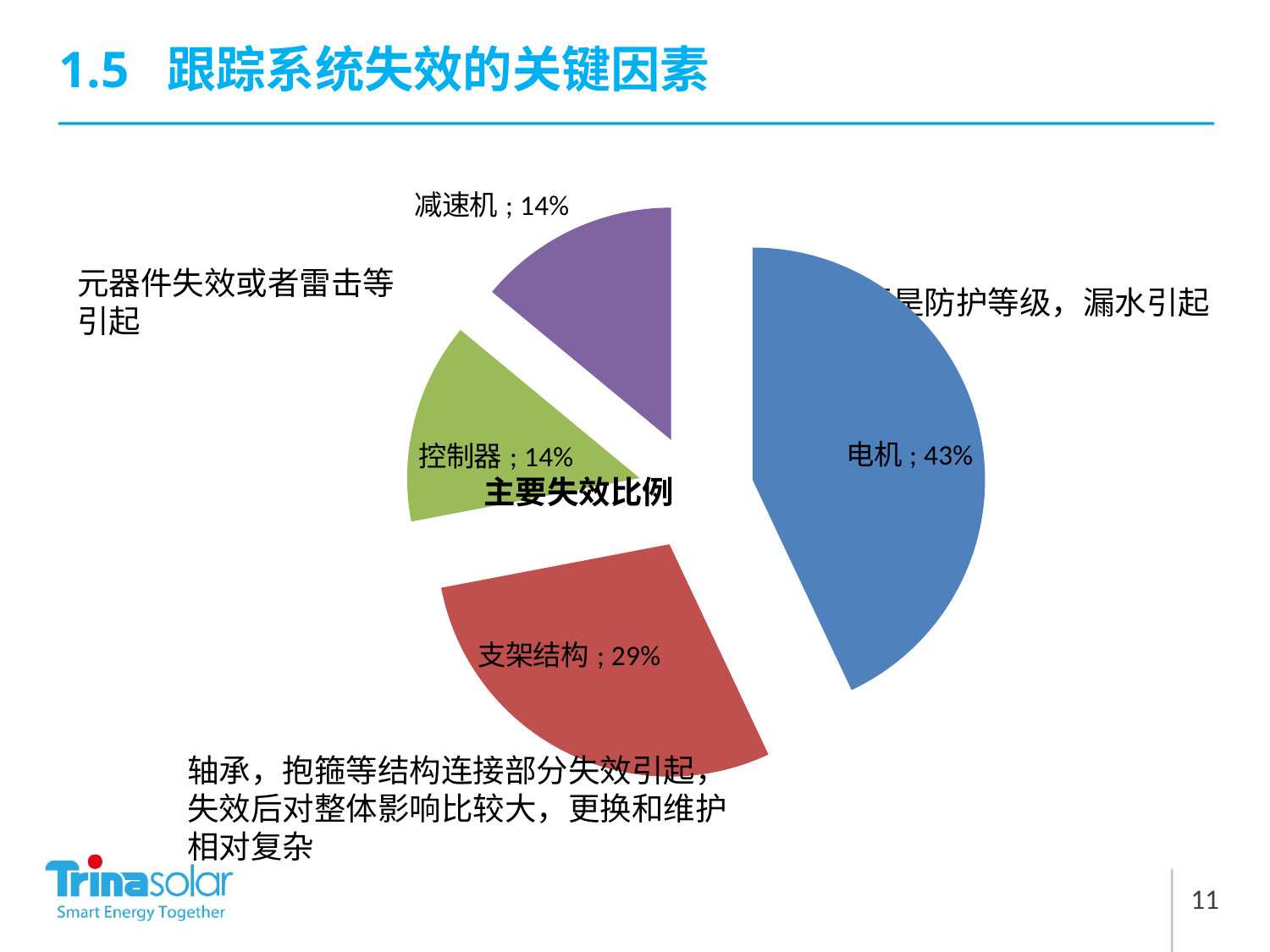
What is the title of the chart? 主要失效比例 What percentage of failures is attributed to 支架结构? 29% How many slices does the pie chart have? 4 What percentage of failures is attributed to 控制器? 14% Which is larger, the share for 电机 or the share for 支架结构? 电机 What is the difference between the share for 电机 and the share for 支架结构? 14% What colour is the 支架结构 slice? red What percentage of failures is attributed to 减速机? 14% What type of chart is shown on the slide? pie chart Which category has the largest share of the pie? 电机 What percentage of failures is attributed to 电机? 43% Do 控制器 and 减速机 have the same share of the pie? yes